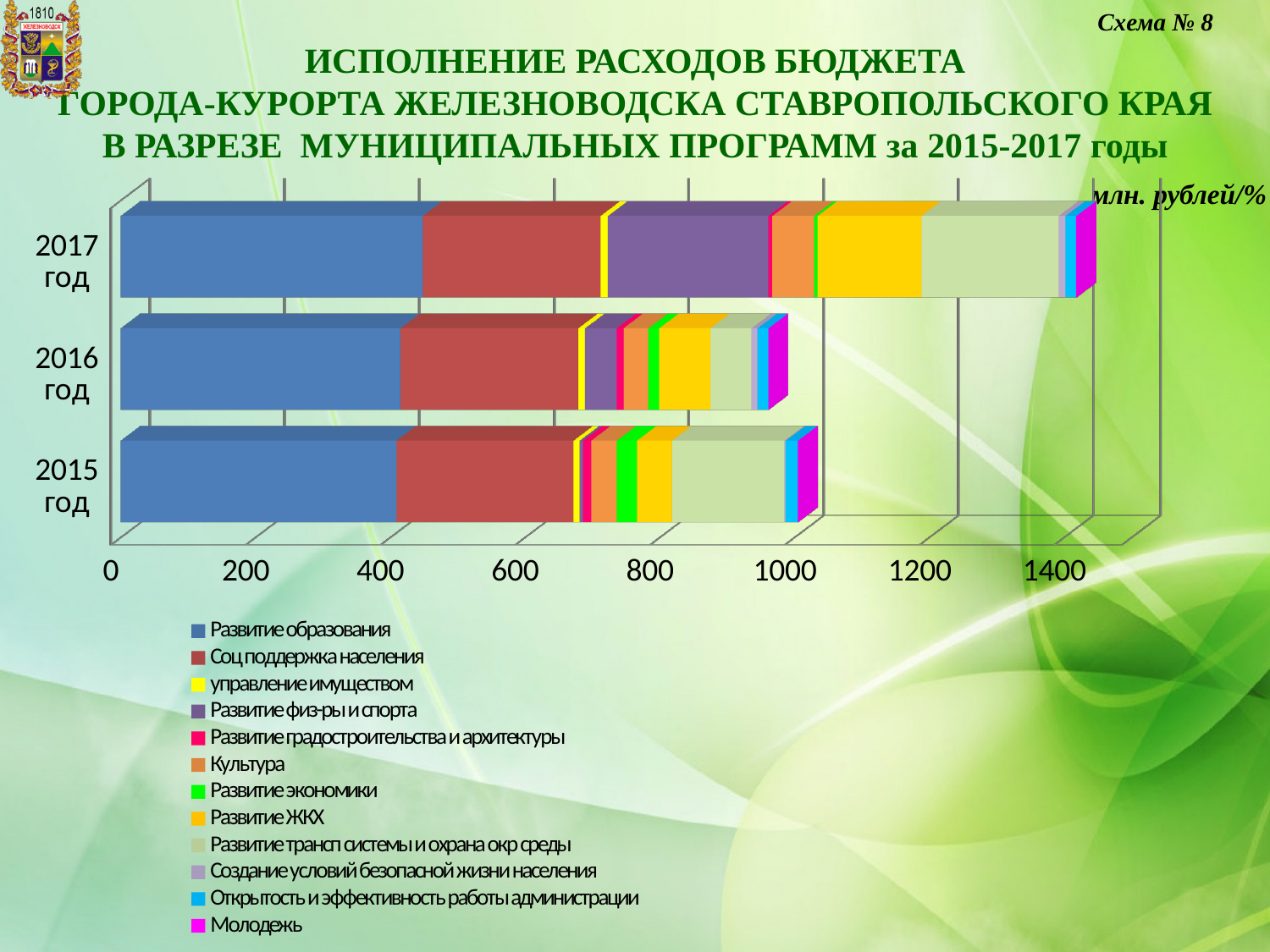
How many series does the legend list? 12 What unit label is shown at the top right of the chart? млн. рублей/% What kind of chart is shown on the slide? Stacked bar chart Which year has the longest total bar? 2017 год Which series is shown in magenta in the legend? Молодежь How many years (bars) are shown in the chart? 3 Which series forms the largest segment in every bar? Развитие образования Is the total bar for 2017 год greater or less than 1200? greater Is the value for Развитие образования in 2017 год greater or less than 400? greater Which total bar is longer, 2017 год or 2016 год? 2017 год Is the total bar for 2016 год greater or less than 1000? less